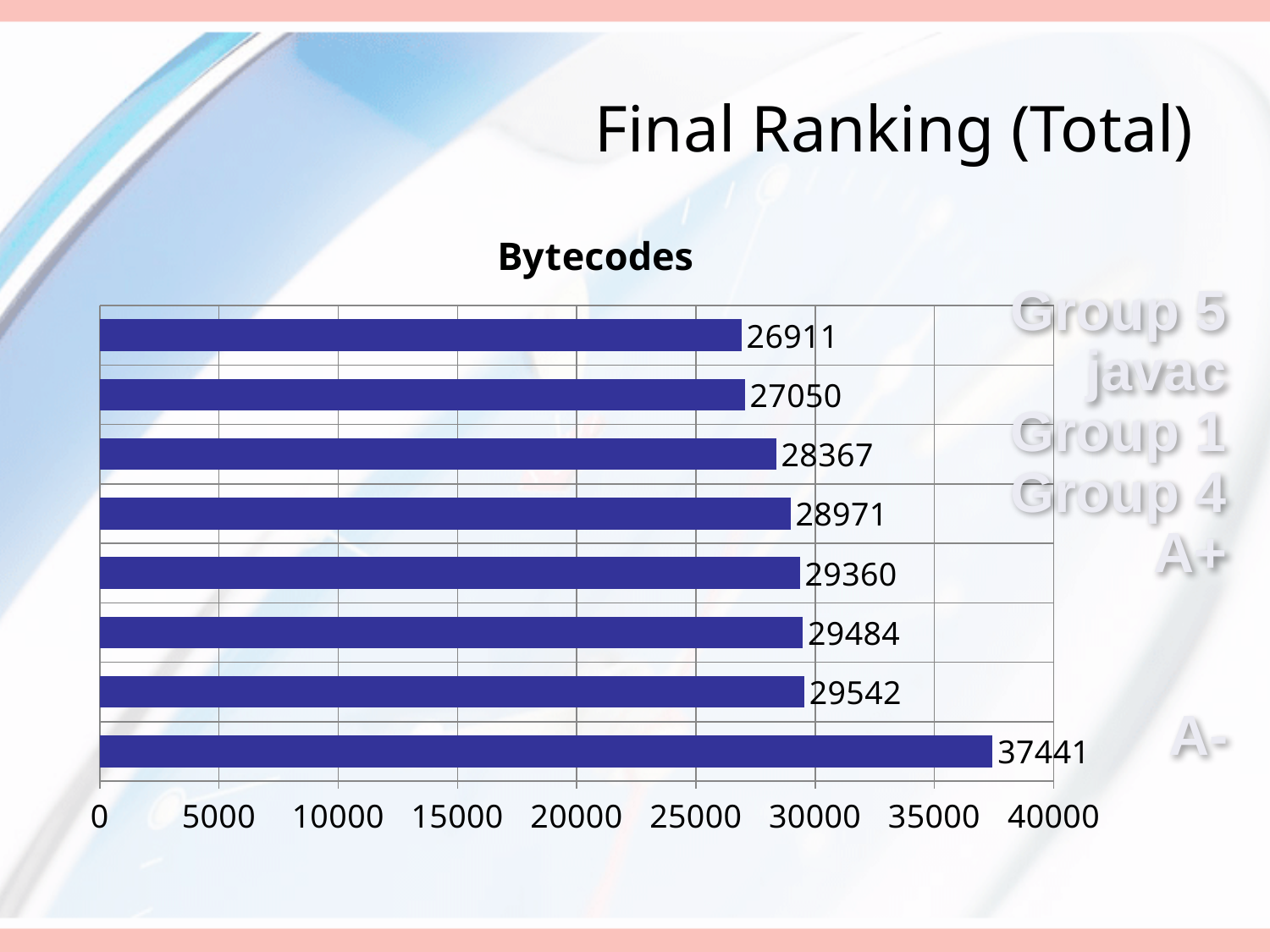
What is the value of the topmost bar in the chart? 26911 What is the value of the bottom bar in the chart? 37441 How many bars have a value greater than 30000? 1 What is the smallest value shown in the chart? 26911 What is the title of the chart? Bytecodes What kind of chart is shown on the slide? bar chart What is the largest value shown in the chart? 37441 How many bars does the chart contain? 8 Which is larger, the topmost bar or the second bar from the top? the second bar from the top (27050) What is the difference between the bottom bar (37441) and the bar directly above it (29542)? 7899 What is the difference between the largest and smallest values in the chart? 10530 Is the value of the longest bar greater or less than 35000? greater